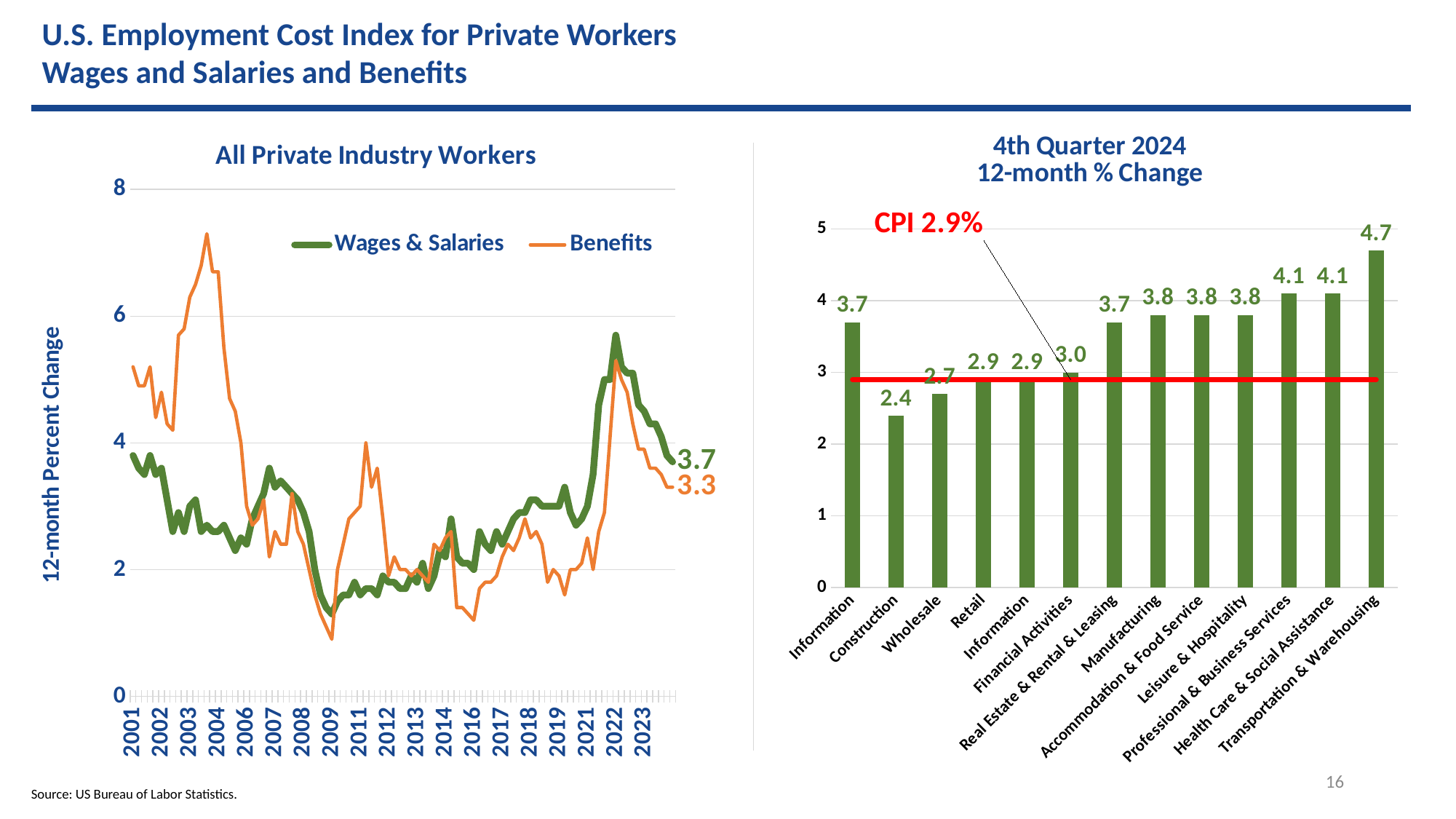
In the '4th Quarter 2024 12-month % Change' chart, which industry has the lowest value? Construction What CPI value is marked by the red line in the '4th Quarter 2024 12-month % Change' chart? 2.9% In the '4th Quarter 2024 12-month % Change' chart, what is the difference between the values for Transportation & Warehousing and Construction? 2.3 In the 'All Private Industry Workers' chart, what is the final labelled value of the Wages & Salaries line? 3.7 In the '4th Quarter 2024 12-month % Change' chart, which is larger, the value for Wholesale or the value for Retail? Retail In the '4th Quarter 2024 12-month % Change' chart, what is the value for Construction? 2.4 What kind of chart is the '4th Quarter 2024 12-month % Change' chart on the right? bar chart How many bars are shown in the '4th Quarter 2024 12-month % Change' chart? 13 In the '4th Quarter 2024 12-month % Change' chart, which industry has the highest value? Transportation & Warehousing In the '4th Quarter 2024 12-month % Change' chart, what is the value for Transportation & Warehousing? 4.7 How many series does the legend of the 'All Private Industry Workers' chart list? 2 In the '4th Quarter 2024 12-month % Change' chart, what is the value for Manufacturing? 3.8